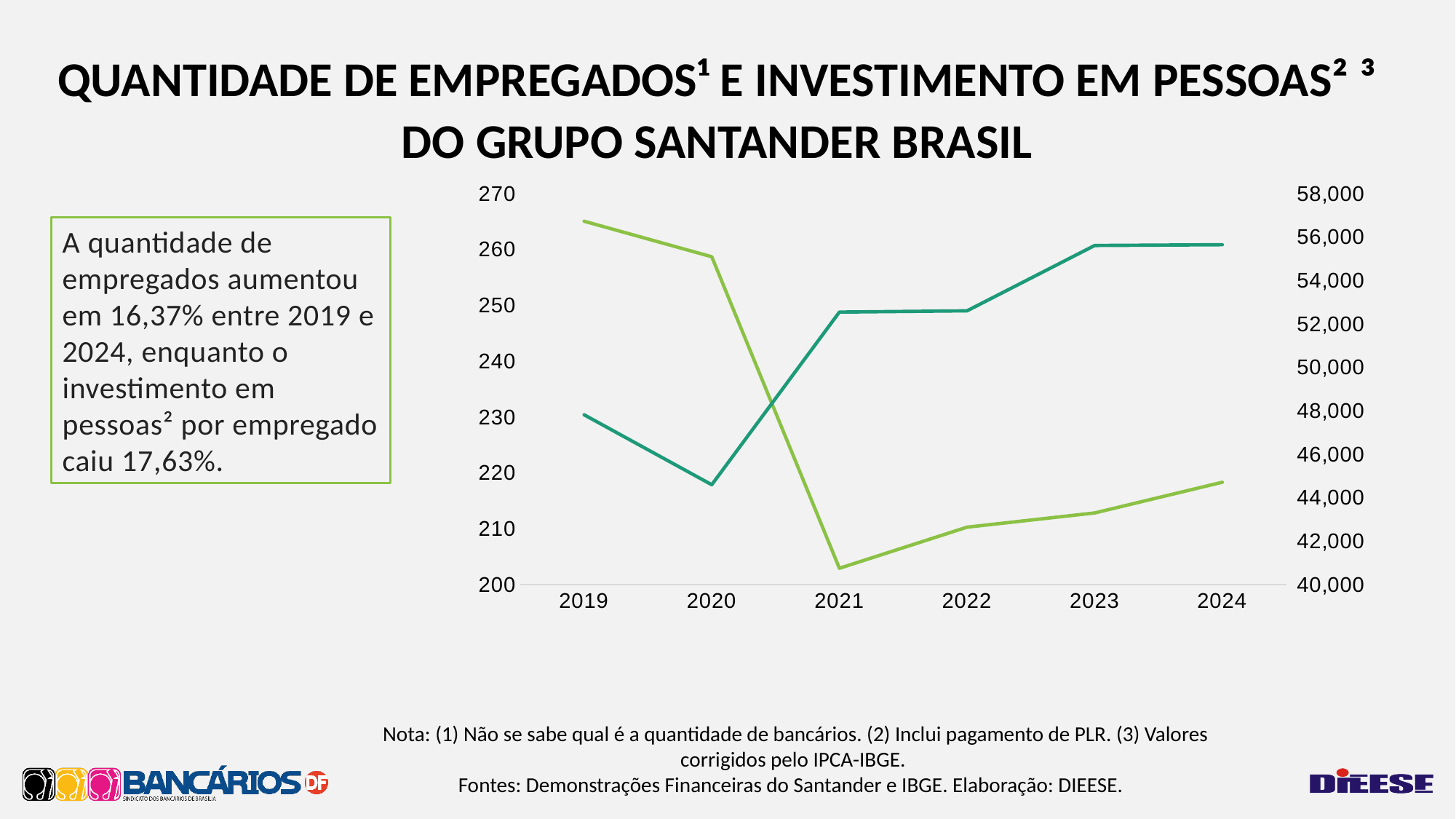
Does the light green line rise or fall between 2019 and 2021? fall Reading the dark teal line against the right-hand axis, is its 2020 value greater or less than 46,000? less Does the dark teal line rise or fall between 2020 and 2023? rise How many years are plotted along the x axis of the chart? 6 In which year does the light green line reach its lowest point? 2021 In 2024, which line is higher on the chart, the light green line or the dark teal line? dark teal line In which year does the light green line reach its highest point? 2019 What kind of chart is shown on the slide? line chart How many lines are plotted on the chart? 2 In which year does the dark teal line reach its lowest point? 2020 Reading the light green line against the left-hand axis, is its 2021 value greater or less than 210? less In 2019, which line is higher on the chart, the light green line or the dark teal line? light green line